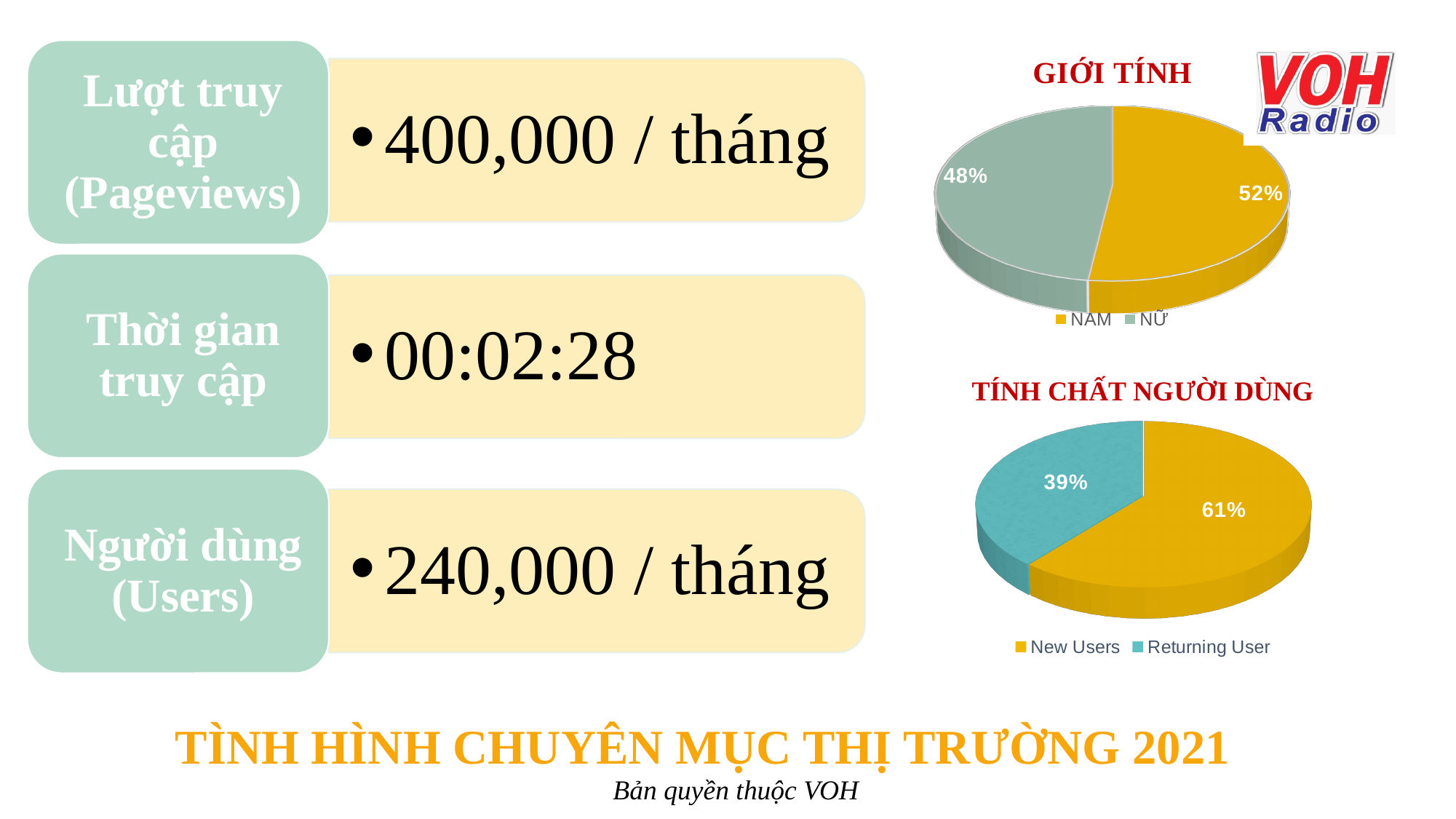
What colour is the New Users slice in the TÍNH CHẤT NGƯỜI DÙNG chart? Yellow In the TÍNH CHẤT NGƯỜI DÙNG chart, which slice is the largest? New Users In the GIỚI TÍNH chart, what share is labelled for NAM? 52% How many entries does the legend of the TÍNH CHẤT NGƯỜI DÙNG chart list? 2 How many slices does the GIỚI TÍNH pie chart have? 2 In the GIỚI TÍNH chart, what share is labelled for NỮ? 48% In the GIỚI TÍNH chart, which slice is larger, NAM or NỮ? NAM In the TÍNH CHẤT NGƯỜI DÙNG chart, what share is labelled for New Users? 61% In the TÍNH CHẤT NGƯỜI DÙNG chart, what is the difference in percentage points between New Users and Returning User? 22 percentage points In the TÍNH CHẤT NGƯỜI DÙNG chart, what share is labelled for Returning User? 39% What kind of chart is the GIỚI TÍNH chart? Pie chart In the GIỚI TÍNH chart, what is the difference in percentage points between NAM and NỮ? 4 percentage points